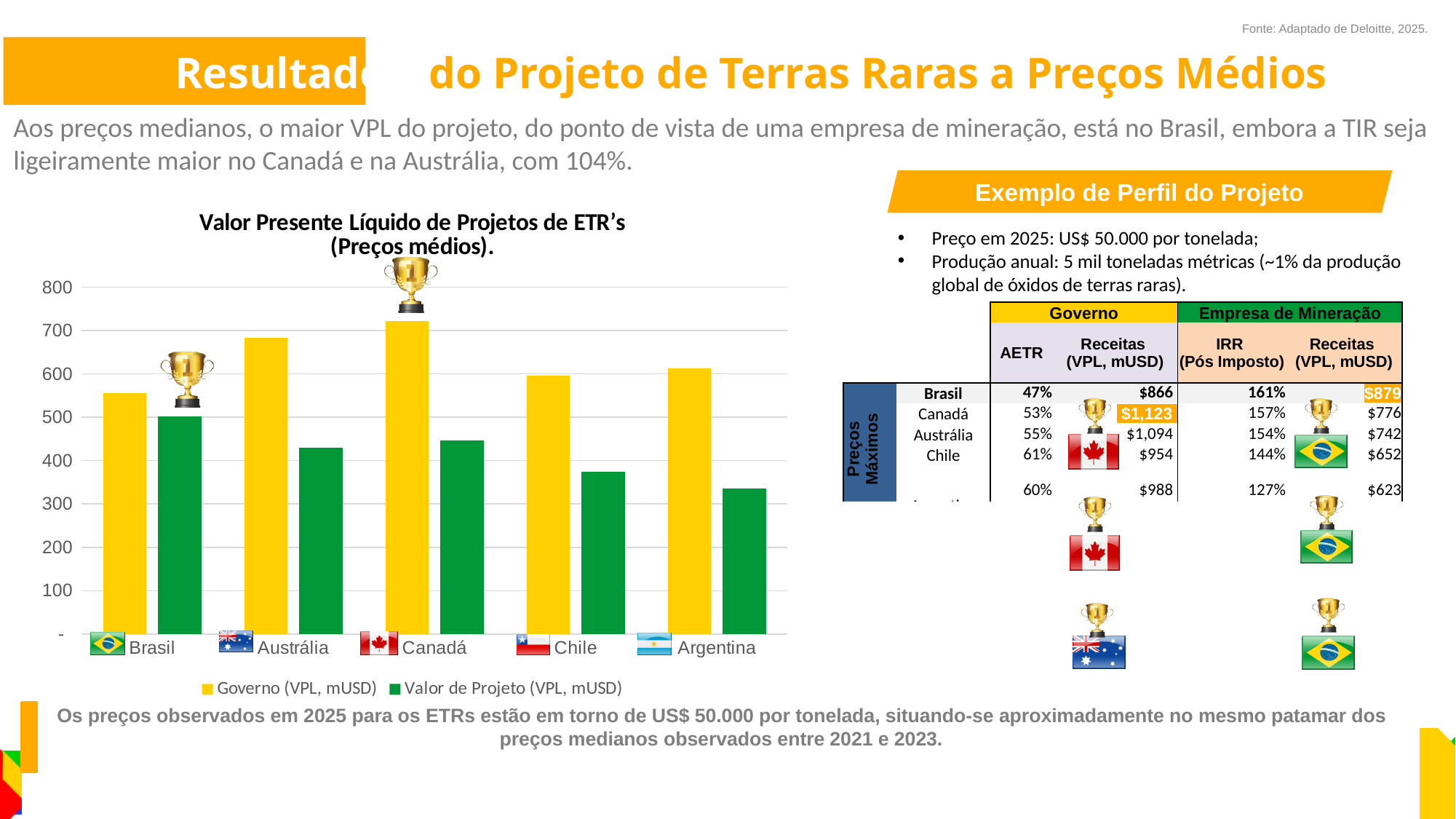
Which country has the lowest Governo (VPL, mUSD) bar? Brasil Which country has the highest Governo (VPL, mUSD) bar? Canadá For Brasil, which is larger: the Governo (VPL, mUSD) bar or the Valor de Projeto (VPL, mUSD) bar? Governo (VPL, mUSD) Is the Governo (VPL, mUSD) value for Austrália greater or less than 600? greater Which colour represents the Valor de Projeto (VPL, mUSD) series in the bar chart? green How many countries are shown on the x axis of the bar chart? 5 Which country has the highest Valor de Projeto (VPL, mUSD) bar? Brasil Which country has the lowest Valor de Projeto (VPL, mUSD) bar? Argentina How many series does the legend of the bar chart list? 2 Is the Valor de Projeto (VPL, mUSD) value for Argentina greater or less than 400? less Is the Governo (VPL, mUSD) value for Canadá greater or less than 700? greater What kind of chart is shown on the left of the slide? bar chart